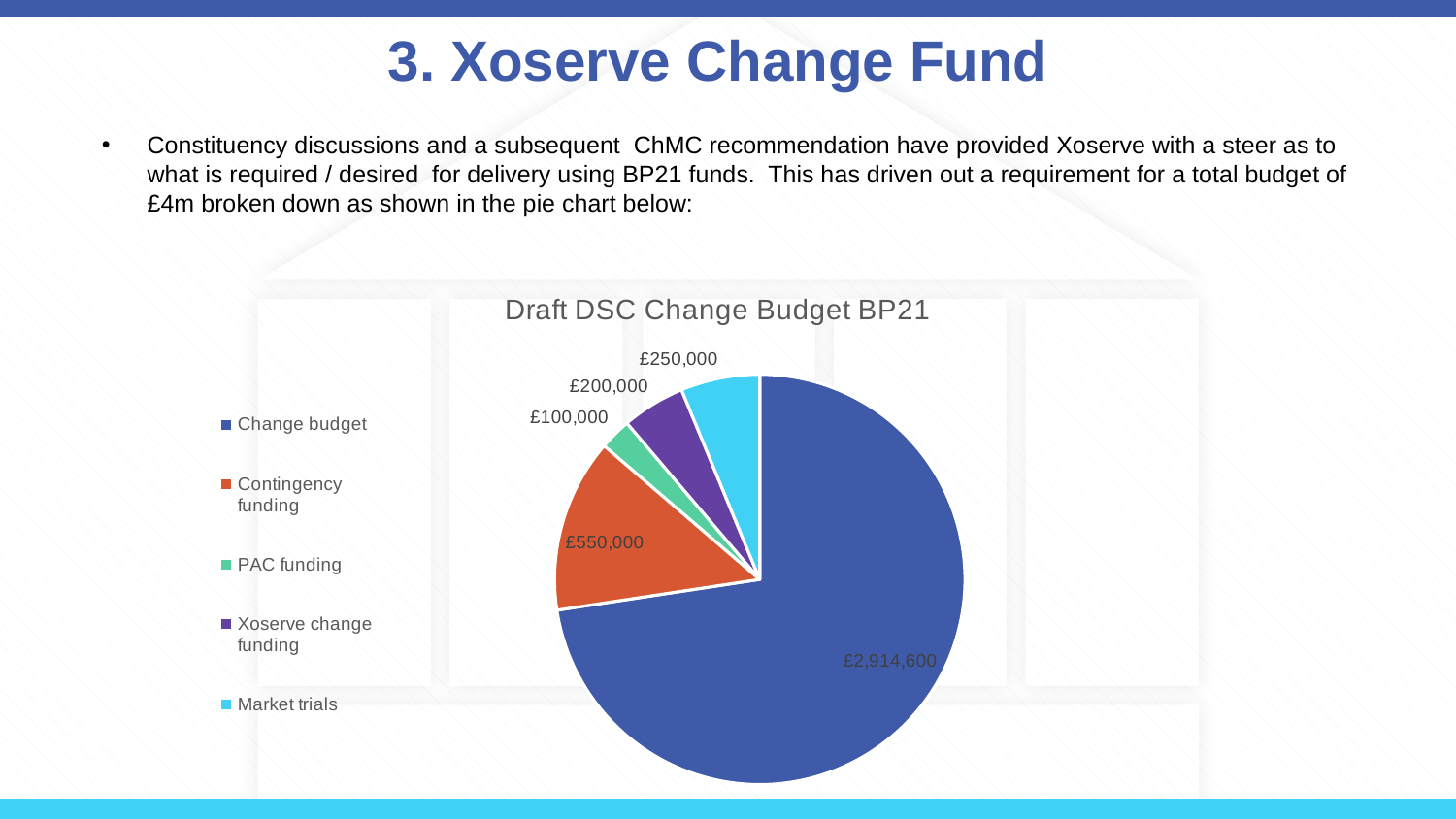
What is the value of the PAC funding slice? £100,000 What is the value of the Market trials slice? £250,000 Which category has the smallest slice of the pie? PAC funding What is the difference between the Contingency funding and Market trials values? £300,000 What is the total of all slices in the pie chart? £4,014,600 How many categories does the legend list? 5 What is the value of the Contingency funding slice? £550,000 Which is larger, Xoserve change funding or Market trials? Market trials What is the title of the chart? Draft DSC Change Budget BP21 What type of chart is shown on the slide? Pie chart What is the value of the Change budget slice? £2,914,600 Which category has the largest slice of the pie? Change budget